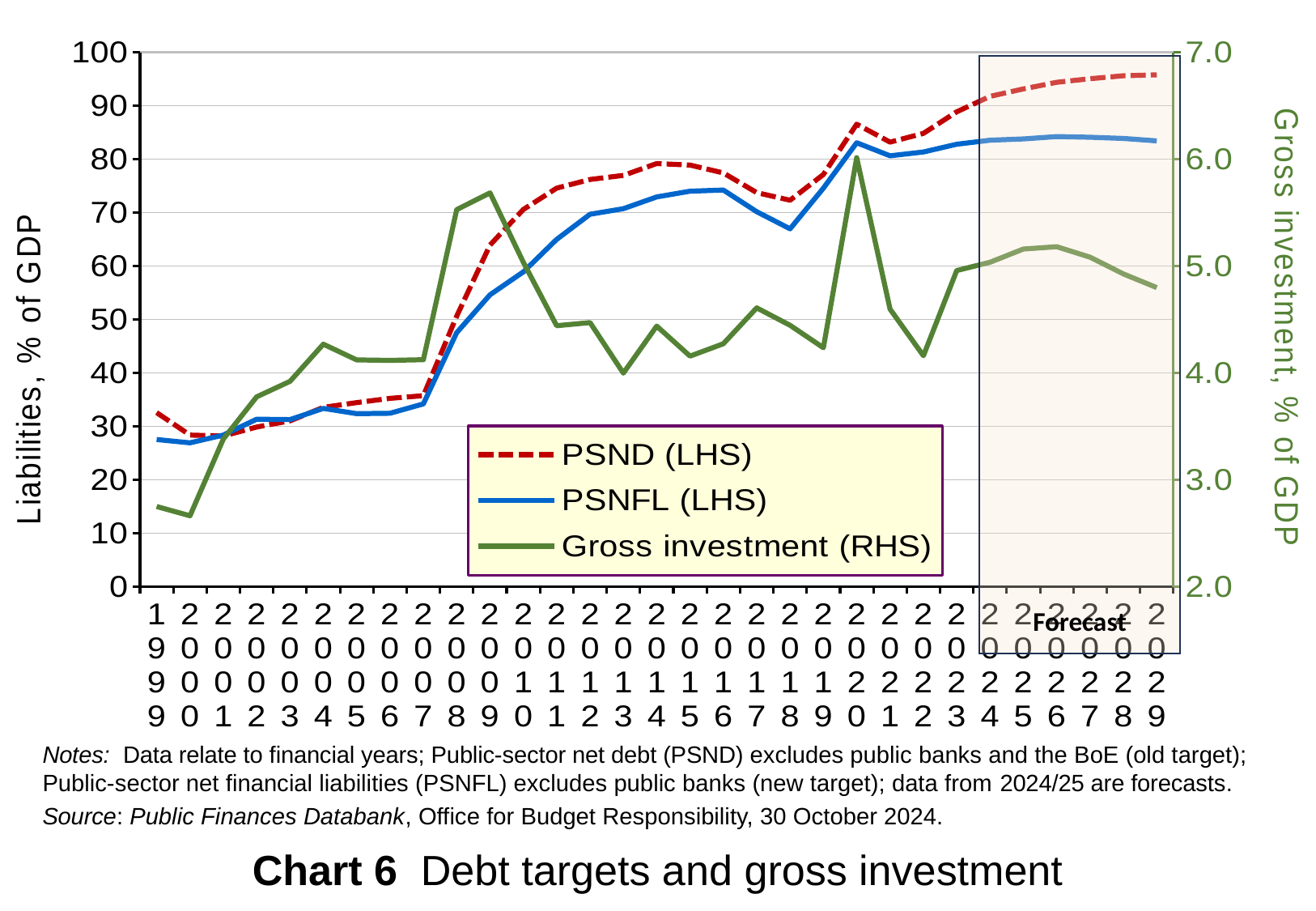
Is the value of PSNFL (LHS) in 2029 greater or less than 90? less How many years are shown along the x axis? 31 Which series is drawn with a dashed line? PSND (LHS) Is the value of Gross investment (RHS) in 2000 greater or less than 3.0? less Is the value of Gross investment (RHS) in 2020 greater or less than 5.0? greater In 2029, which is larger, PSND (LHS) or PSNFL (LHS)? PSND (LHS) Does PSND (LHS) overall rise or fall from 1999 to 2029? rise What kind of chart is shown on the slide? line chart How many series does the legend list? 3 In which year is Gross investment (RHS) at its lowest? 2000